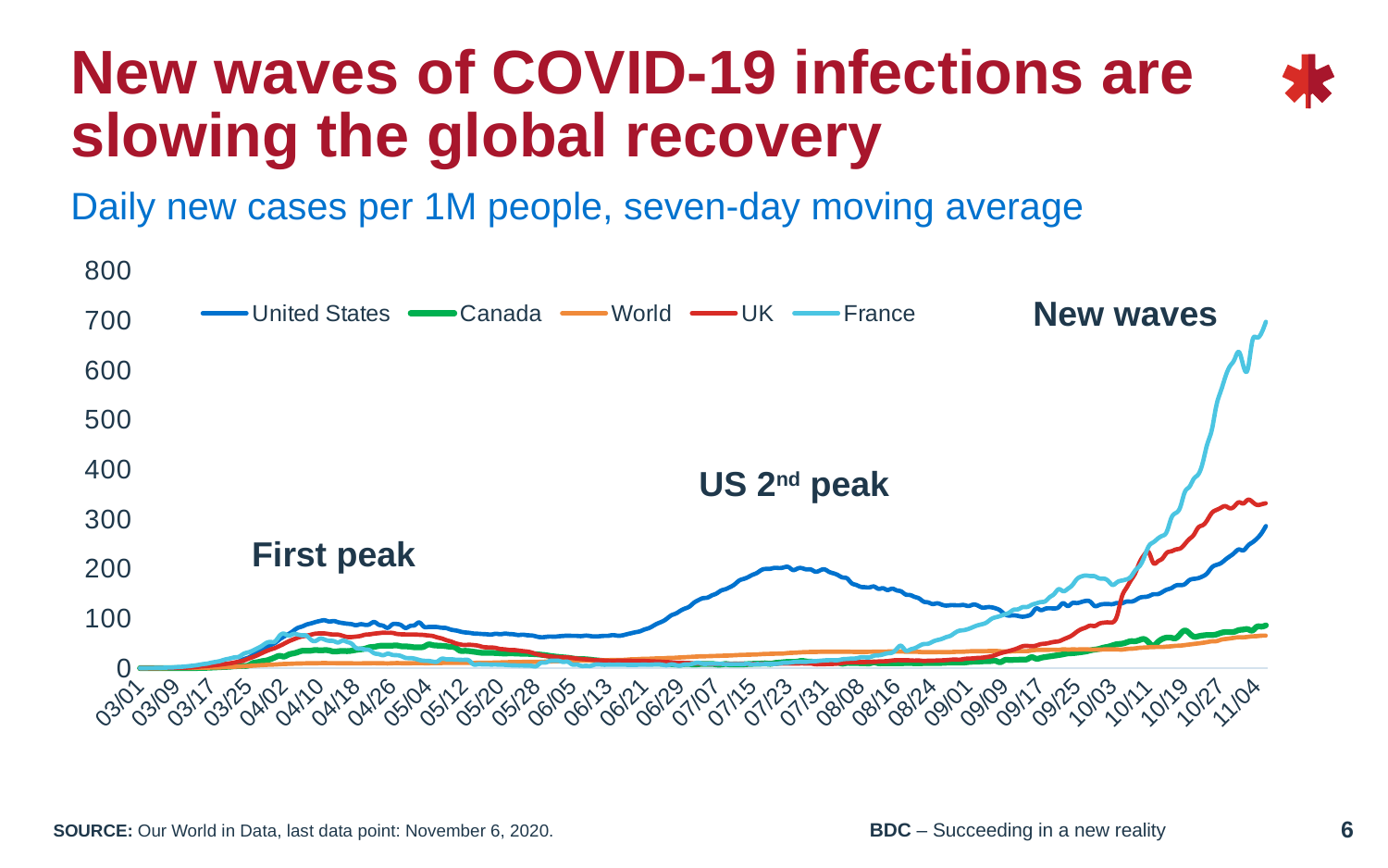
Which series is drawn in green in the legend? Canada Is the value for the United States at 07/23 greater or less than 100? greater Does the value for France rise or fall between 09/01 and 11/04? rise Which series has the highest value at the last date, 11/04? France What is the subtitle describing the measure plotted in the chart? Daily new cases per 1M people, seven-day moving average What kind of chart is shown on the slide? line chart Is the value for the UK at 11/04 greater or less than 300? greater Is the value for France at 11/04 greater or less than 600? greater Which series has the lowest value at the last date, 11/04? World At 11/04, which is larger: the value for France or the value for the UK? France How many series does the legend list? 5